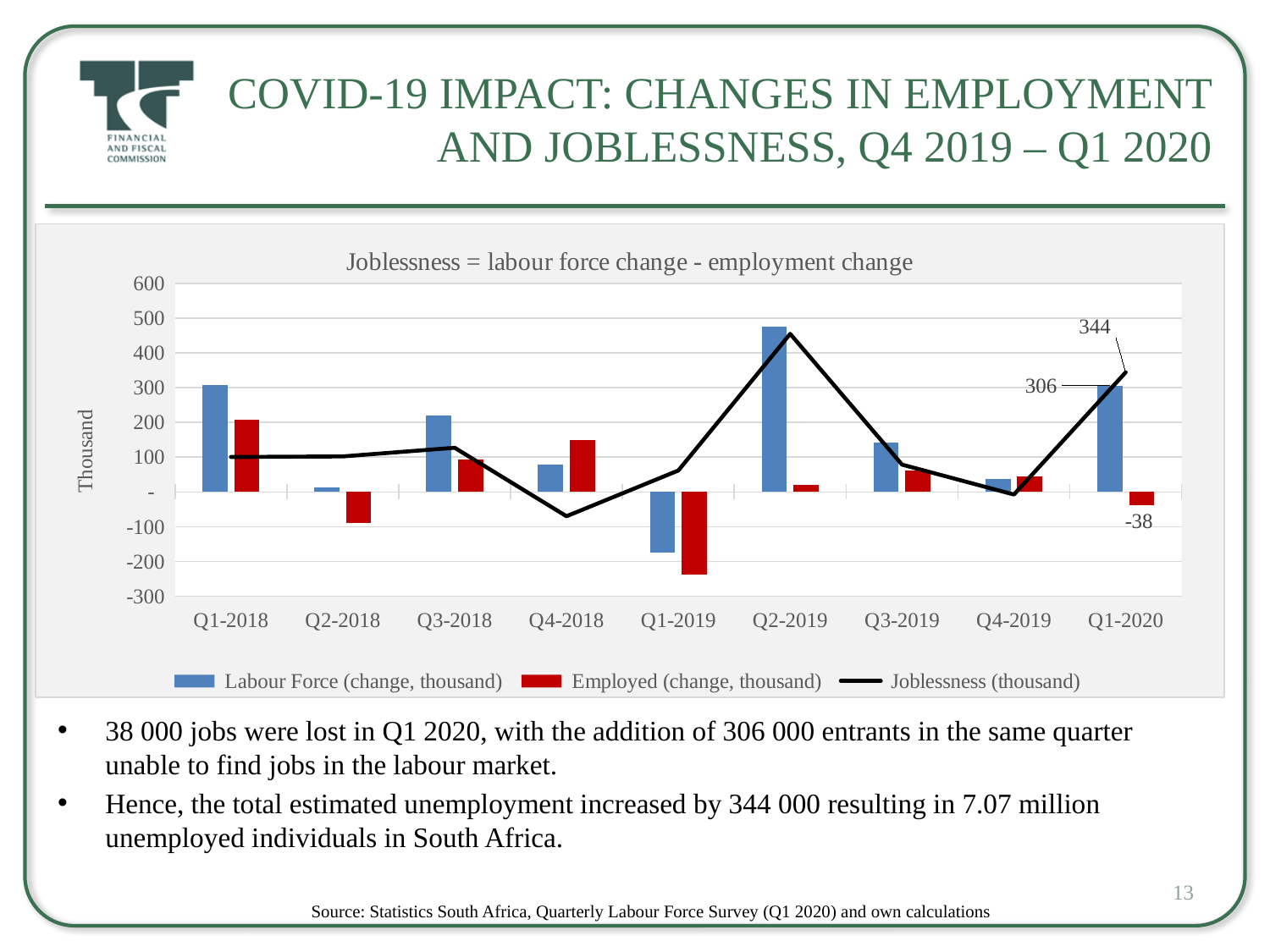
What is the Employed change for Q1-2020? -38 How many series does the legend list? 3 In Q1-2018, which is larger: the Labour Force change or the Employed change? Labour Force change What is the Labour Force change for Q1-2020? 306 What kind of chart is this? Bar and line chart What is the title of the chart? Joblessness = labour force change - employment change Which quarter has the lowest Employed change? Q1-2019 Which quarter has the highest Labour Force change? Q2-2019 Is the Labour Force change for Q2-2019 greater or less than 400? greater What is the Joblessness value for Q1-2020? 344 In Q1-2020, what is the difference between the Labour Force change and the Employed change? 344 How many quarters are shown on the x axis? 9